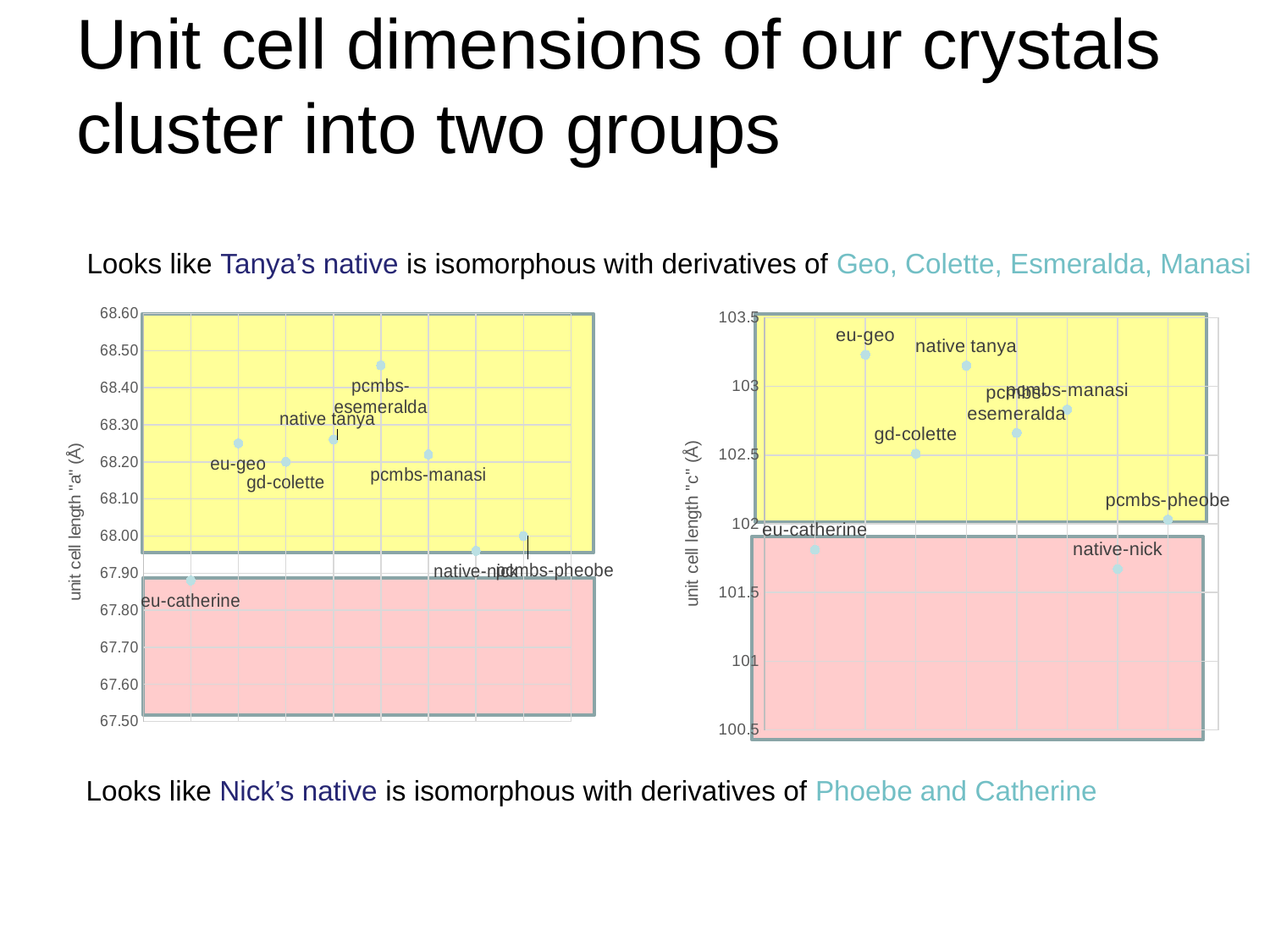
In the right chart (unit cell length "c"), is the value for eu-geo greater or less than 103? greater In the left chart (unit cell length "a"), is the value for pcmbs-esemeralda greater or less than 68.40? greater In the left chart (unit cell length "a"), which crystal has the lowest value? eu-catherine What kind of chart is the left chart showing unit cell length "a"? scatter chart What is the y-axis label of the right chart? unit cell length "c" (Å) How many data points are plotted in the left chart (unit cell length "a")? 8 In the right chart (unit cell length "c"), is the value for native-nick greater or less than 102? less In the right chart (unit cell length "c"), which is larger, the value for native tanya or the value for eu-catherine? native tanya In the left chart (unit cell length "a"), which crystal has the highest value? pcmbs-esemeralda In the left chart (unit cell length "a"), which is larger, the value for pcmbs-esemeralda or the value for gd-colette? pcmbs-esemeralda In the right chart (unit cell length "c"), which crystal has the lowest value? native-nick